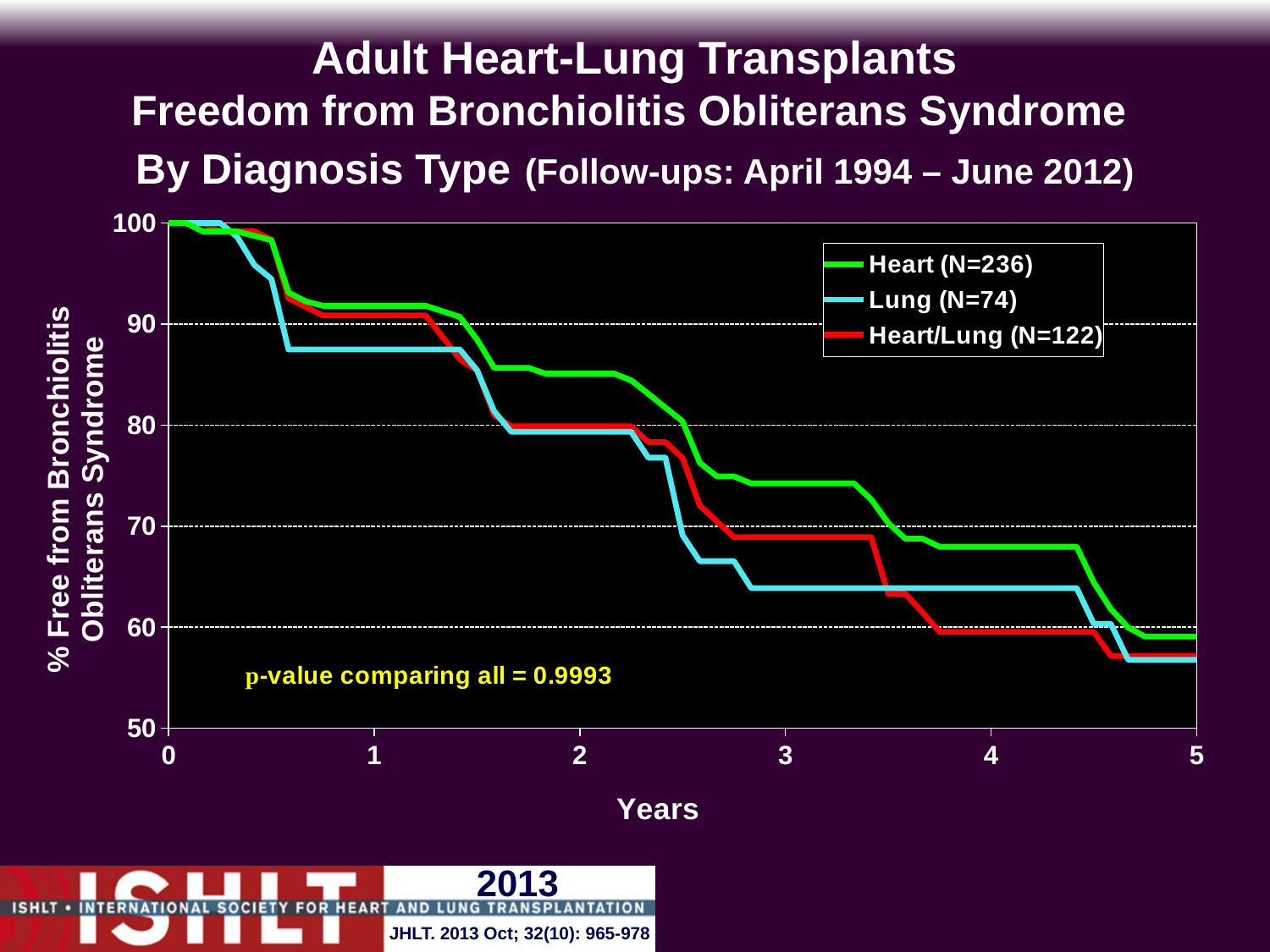
What p-value comparing all groups is shown on the chart? 0.9993 Is the value for the Lung series at 1 year greater or less than 90? less Is the value for the Heart series at 3 years greater or less than 70? greater How many series does the legend list? 3 According to the legend, how many patients are in the Lung group? N=74 Is the value for the Lung series at 5 years greater or less than 60? less Do the values for the Heart series rise or fall as years increase? fall Which series has the lowest value at 3 years? Lung At 3 years, which series has the higher value, Heart or Lung? Heart What kind of chart is shown on the slide? line chart